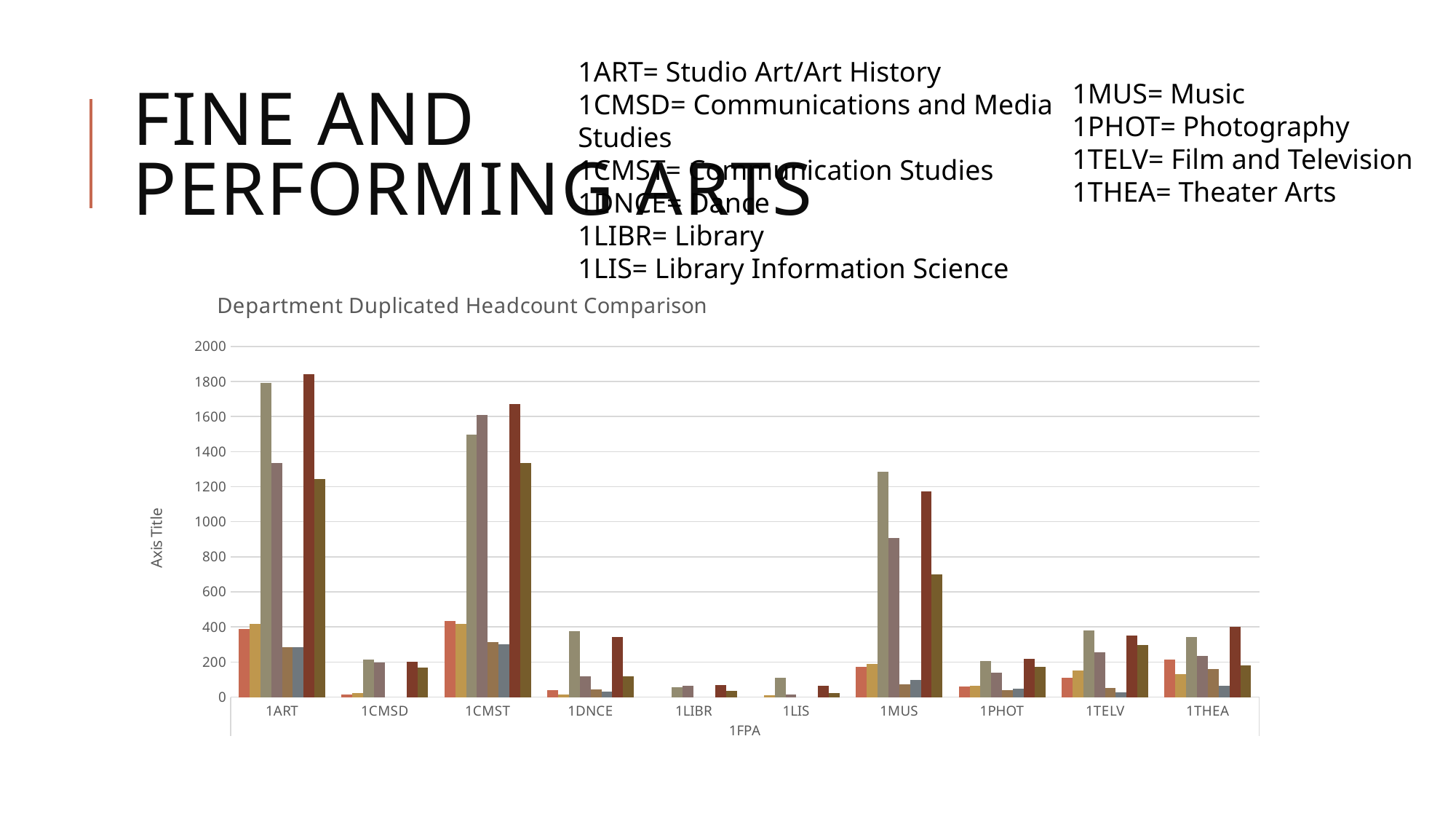
What is the x axis title of the chart? 1FPA What is the title of the chart? Department Duplicated Headcount Comparison Which category has the taller maximum bar, 1MUS or 1THEA? 1MUS Which category has the taller maximum bar, 1ART or 1CMST? 1ART Is the tallest bar in the 1LIBR category greater or less than 200? less What type of chart is shown on the slide? bar chart Is the tallest bar in the 1CMSD category greater or less than 400? less Which category contains the tallest bar in the chart? 1ART Is the tallest bar in the 1MUS category greater or less than 1000? greater How many categories are shown on the x axis of the chart? 10